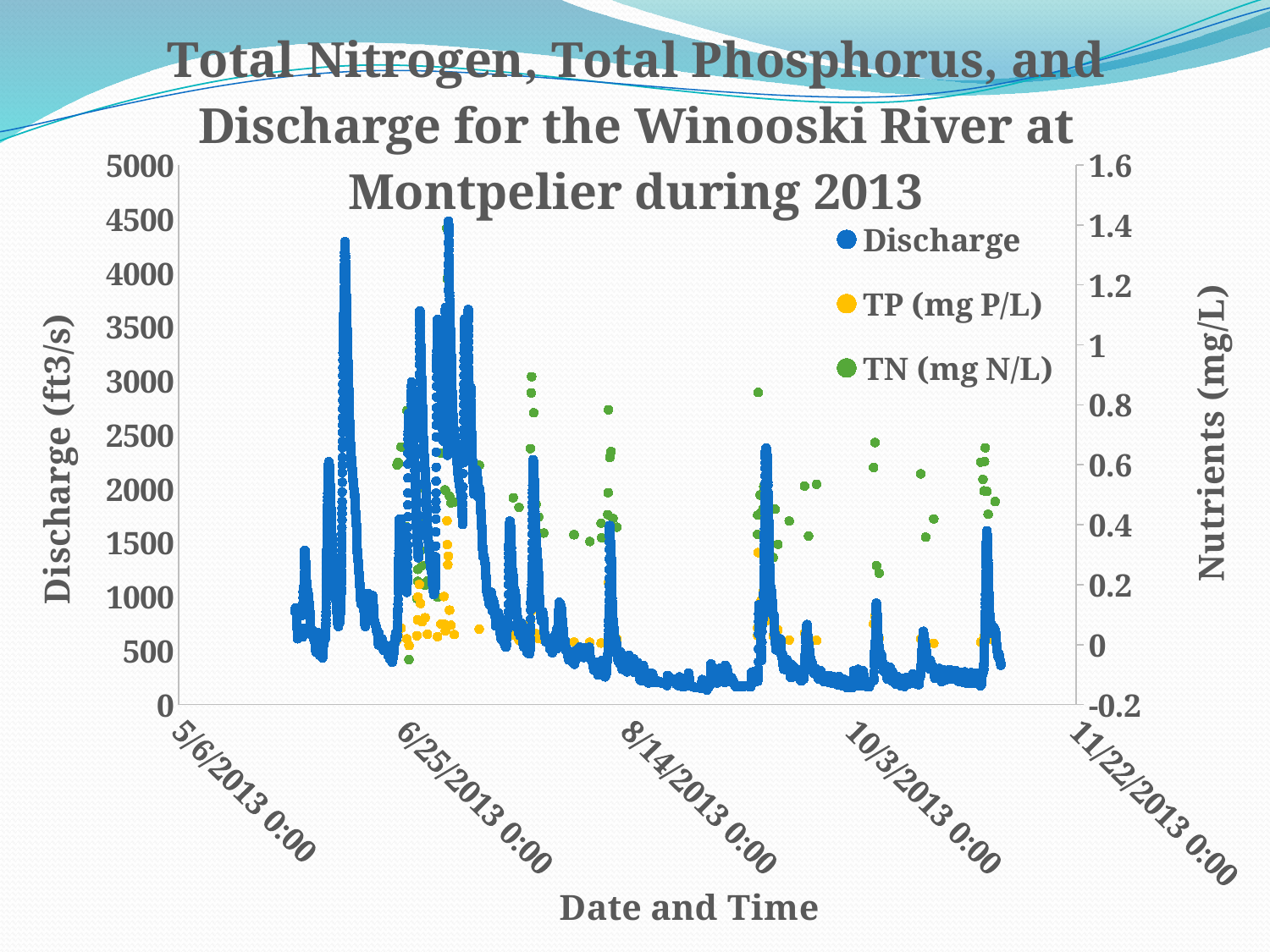
What is the maximum value shown on the right Nutrients axis? 1.6 How many series does the legend list? 3 Is the highest TN (mg N/L) value on the chart greater or less than 1? less What is the title of the chart? Total Nitrogen, Total Phosphorus, and Discharge for the Winooski River at Montpelier during 2013 Is the highest Discharge value on the chart greater or less than 4000? greater What is the maximum value shown on the left Discharge axis? 5000 Is the Discharge value at the peak near 10/3/2013 greater or less than 3000? less What kind of chart is shown on the slide? scatter chart How many date labels are shown on the x axis? 5 What is the label of the left vertical axis? Discharge (ft3/s)